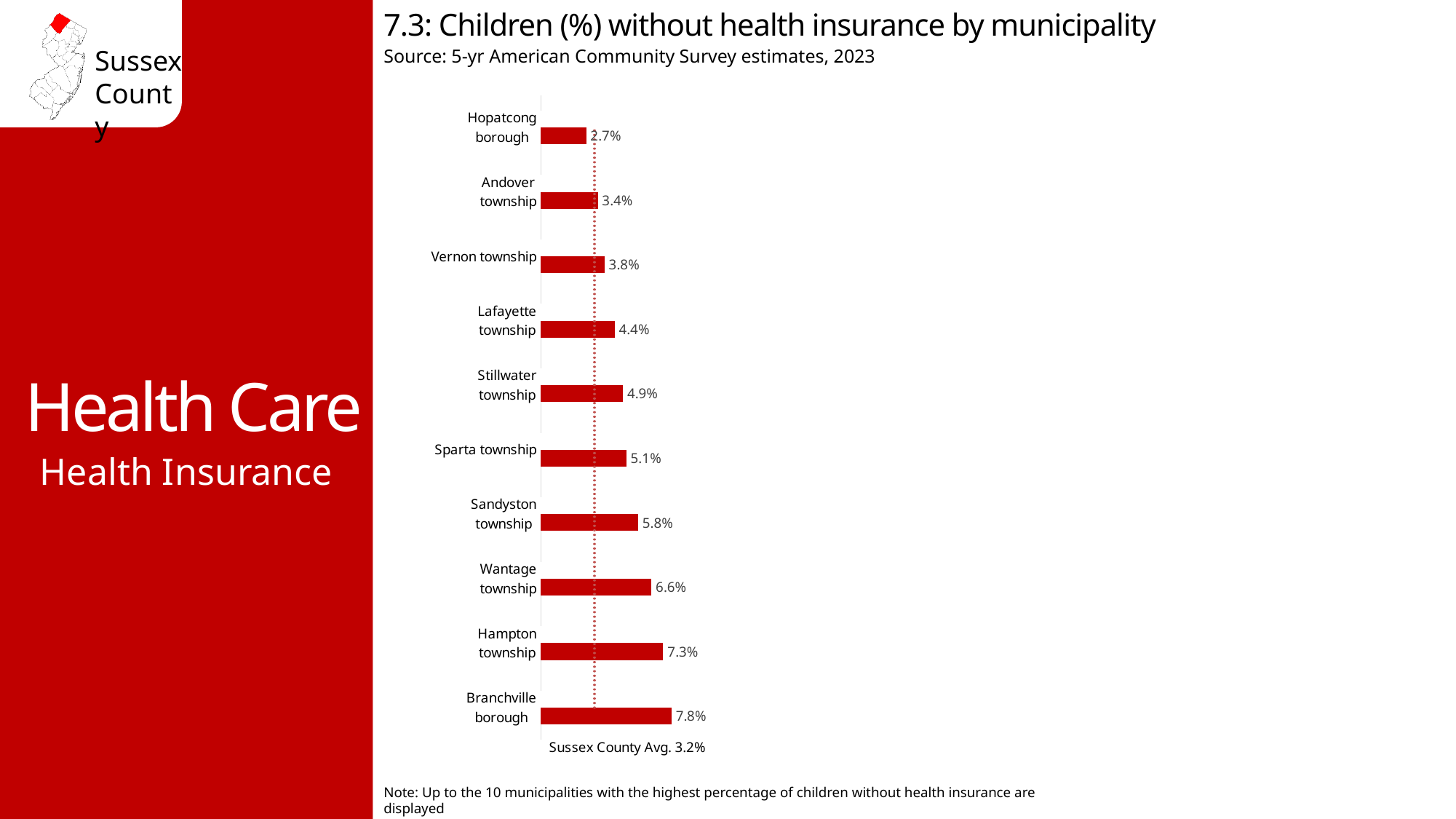
What is the Sussex County average shown by the dotted line? 3.2% What is the difference between the values for Branchville borough and Hopatcong borough? 5.1% What is the value shown for Sparta township? 5.1% What is the value shown for Hopatcong borough? 2.7% Which municipality has the lowest percentage of children without health insurance? Hopatcong borough What is the source of the data in the chart? 5-yr American Community Survey estimates, 2023 What is the difference between the values for Hampton township and Wantage township? 0.7% What kind of chart is shown on the slide? Bar chart Which municipality has the highest percentage of children without health insurance? Branchville borough Which has a higher value, Stillwater township or Lafayette township? Stillwater township How many municipalities are shown in the chart? 10 What percentage of children are without health insurance in Branchville borough? 7.8%